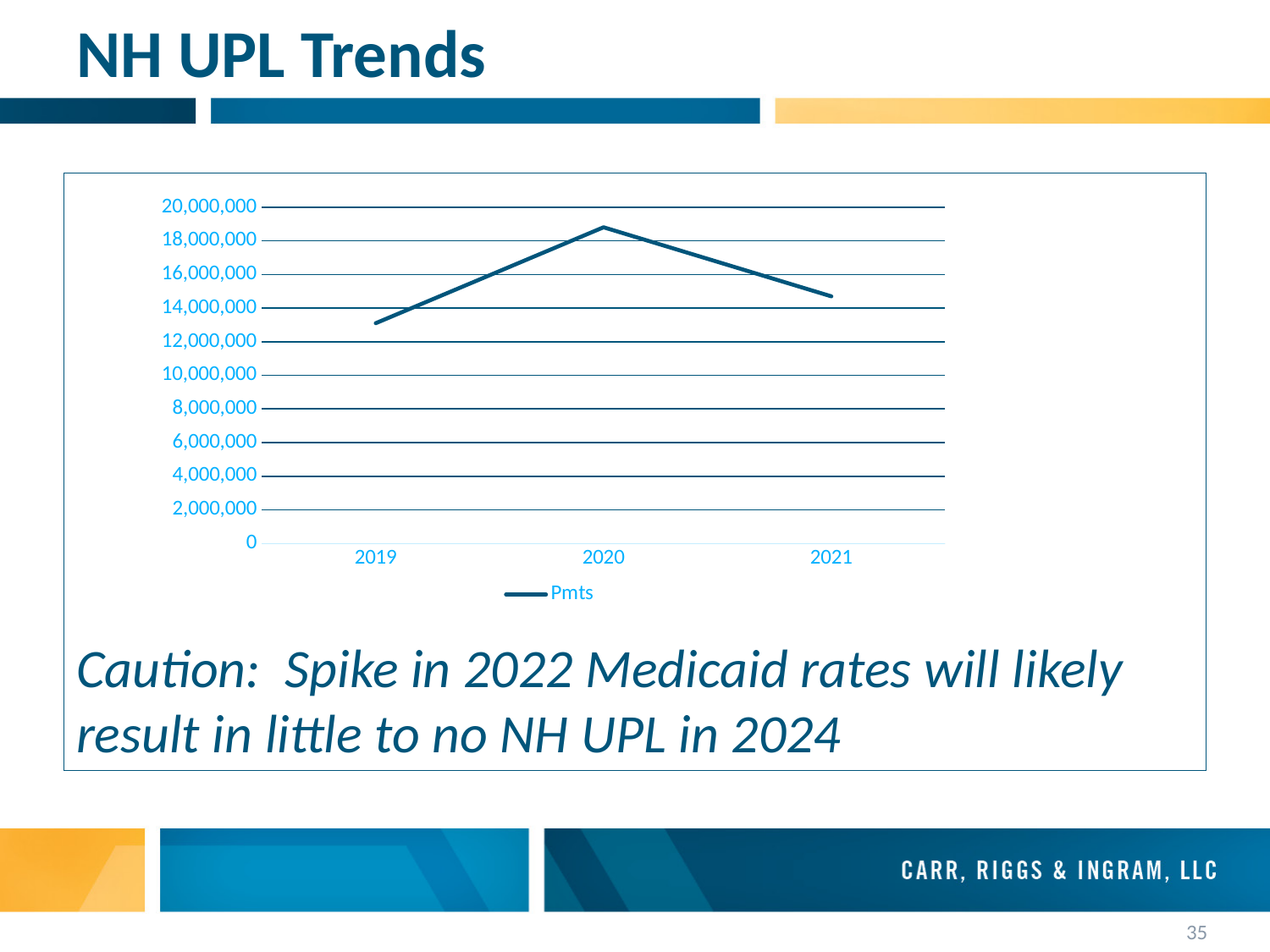
Which year has the lowest Pmts value in the chart? 2019 Does the Pmts line rise or fall from 2020 to 2021? fall Is the Pmts value for 2020 greater or less than 18,000,000? greater What kind of chart is shown on the slide? line chart How many years are plotted on the x axis of the chart? 3 Is the Pmts value for 2021 greater or less than 16,000,000? less How many series does the chart's legend list? 1 What is the title of the slide containing the chart? NH UPL Trends What is the name of the series shown in the chart's legend? Pmts Is the Pmts value for 2019 greater or less than 14,000,000? less Which year has the highest Pmts value in the chart? 2020 Which year has the larger Pmts value, 2019 or 2021? 2021